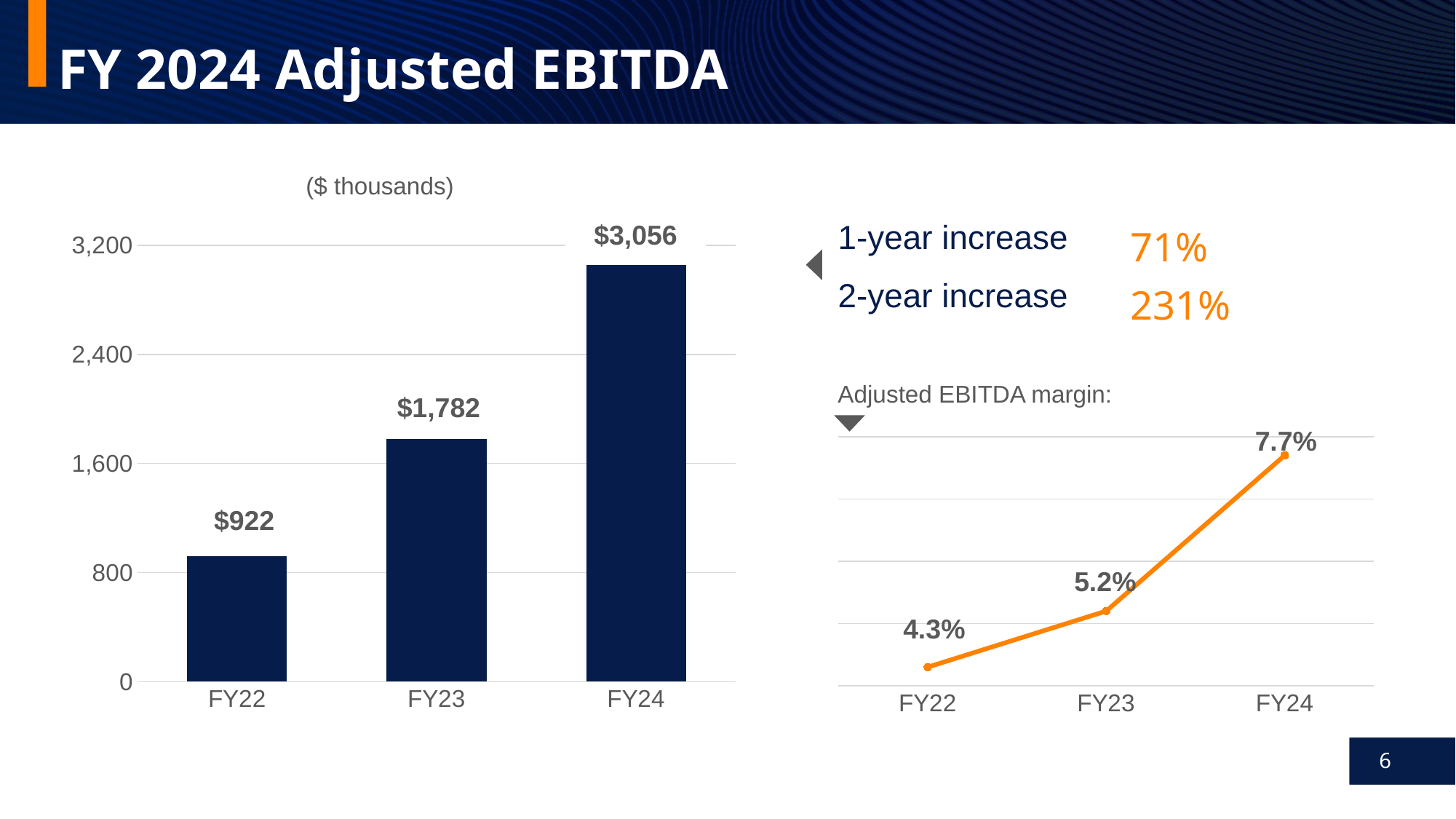
In the Adjusted EBITDA margin chart on the right, what is the margin for FY24? 7.7% In the bar chart on the left, what is the Adjusted EBITDA value for FY22? $922 In the bar chart on the left, what unit is stated above the chart? $ thousands In the bar chart on the left, what is the Adjusted EBITDA value for FY23? $1,782 In the bar chart on the left, which fiscal year has the highest Adjusted EBITDA? FY24 In the bar chart on the left, which fiscal year has the lowest Adjusted EBITDA? FY22 In the bar chart on the left, how many fiscal years are shown? 3 What kind of chart is the chart on the left? Bar chart In the Adjusted EBITDA margin chart on the right, what is the margin for FY23? 5.2% In the bar chart on the left, what is the difference between the FY24 and FY23 values? $1,274 In the Adjusted EBITDA margin chart on the right, do the values rise or fall from FY22 to FY24? Rise What kind of chart is the Adjusted EBITDA margin chart on the right? Line chart